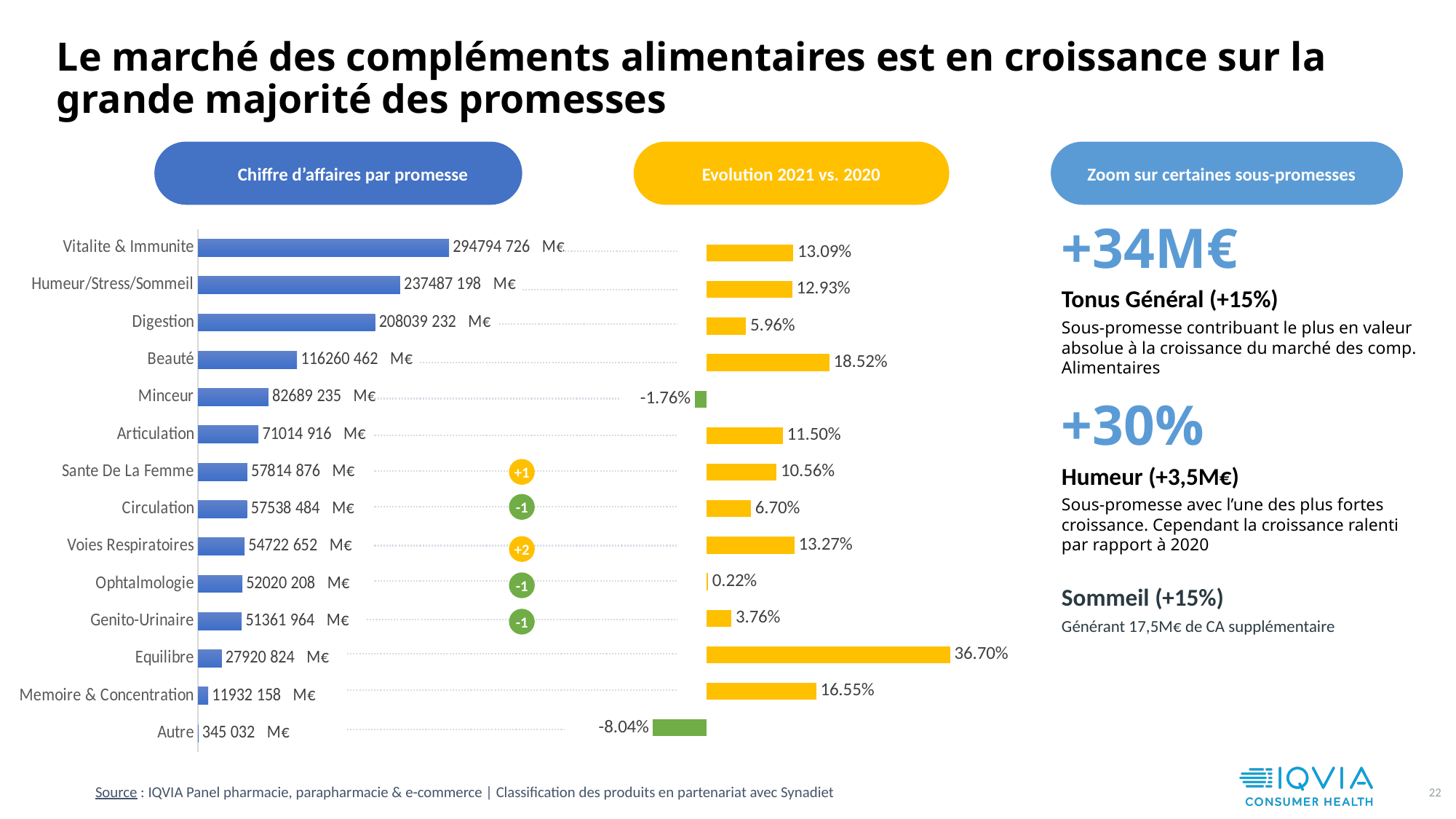
What kind of chart is the 'Chiffre d'affaires par promesse' chart? Bar chart How many categories are shown in the 'Chiffre d'affaires par promesse' chart? 14 In the 'Evolution 2021 vs. 2020' chart, what is the value for Minceur? -1.76% In the 'Evolution 2021 vs. 2020' chart, what is the value for Beauté? 18.52% In the 'Evolution 2021 vs. 2020' chart, which is larger: the value for Digestion or the value for Circulation? Circulation In the 'Chiffre d'affaires par promesse' chart, which category has the highest value? Vitalite & Immunite In the 'Evolution 2021 vs. 2020' chart, what colour are the bars with negative values? Green In the 'Chiffre d'affaires par promesse' chart, which category has the lowest value? Autre In the 'Evolution 2021 vs. 2020' chart, which category has the highest value? Equilibre In the 'Evolution 2021 vs. 2020' chart, which category has the lowest value? Autre In the 'Evolution 2021 vs. 2020' chart, what is the difference between the values for Equilibre and Memoire & Concentration? 20.15 percentage points In the 'Chiffre d'affaires par promesse' chart, what is the value for Digestion? 208039 232 M€